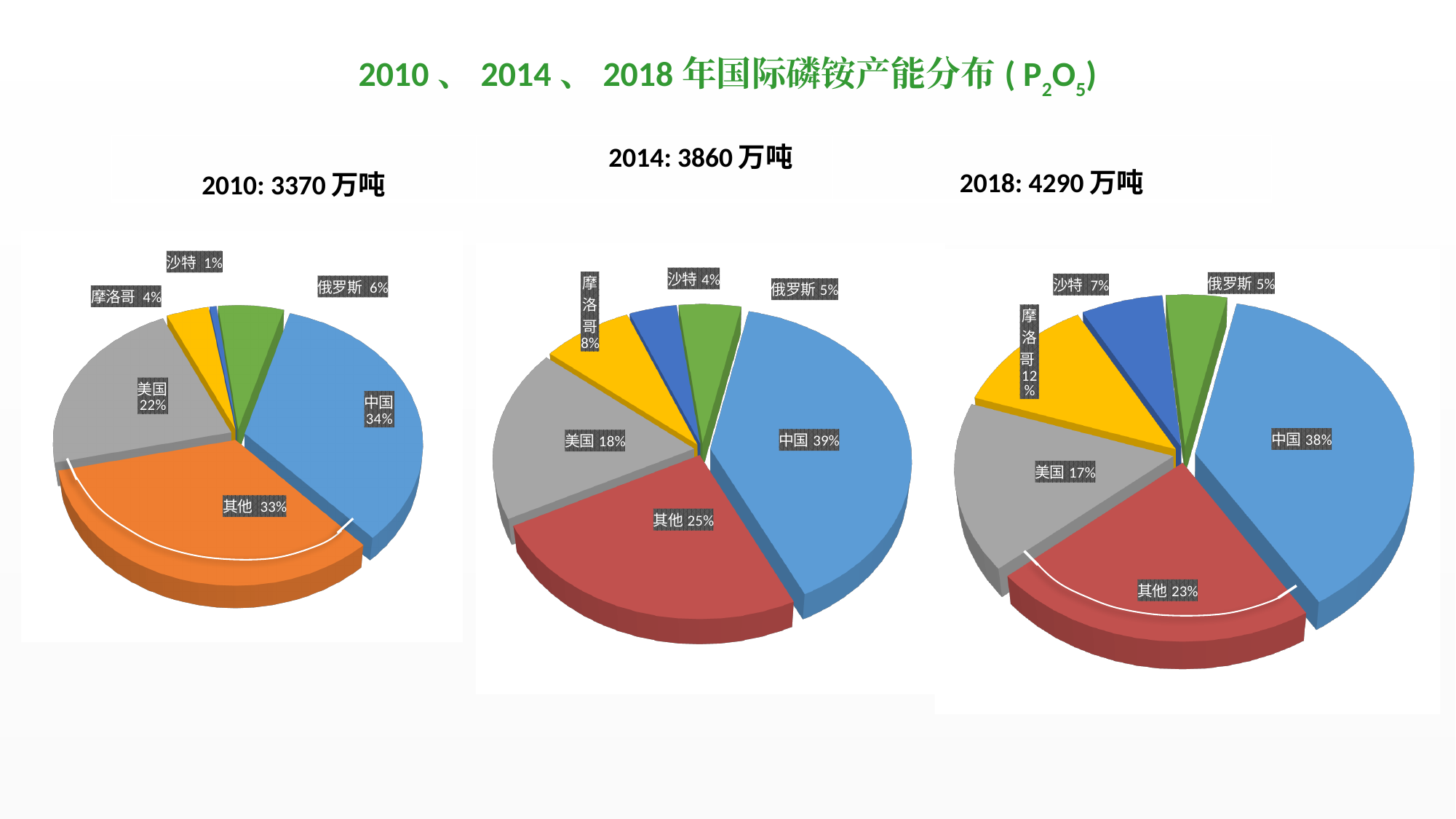
In the 2018 pie chart, what share does 摩洛哥 have? 12% In the 2010 pie chart, which category has the smallest share? 沙特 What total capacity is shown above the 2014 pie chart? 3860 万吨 In the 2018 pie chart, what colour is the 中国 slice? Blue In the 2010 pie chart, what is the difference between the shares of 美国 and 俄罗斯? 16% In the 2014 pie chart, which is larger, the share of 摩洛哥 or the share of 沙特? 摩洛哥 In the 2018 pie chart, what is the difference between the shares of 中国 and 其他? 15% In the 2010 pie chart, what share does 中国 have? 34% What kind of chart is used for the 2010 data? Pie chart In the 2014 pie chart, what share does 美国 have? 18% In the 2014 pie chart, which category has the largest share? 中国 How many slices does the 2018 pie chart have? 6